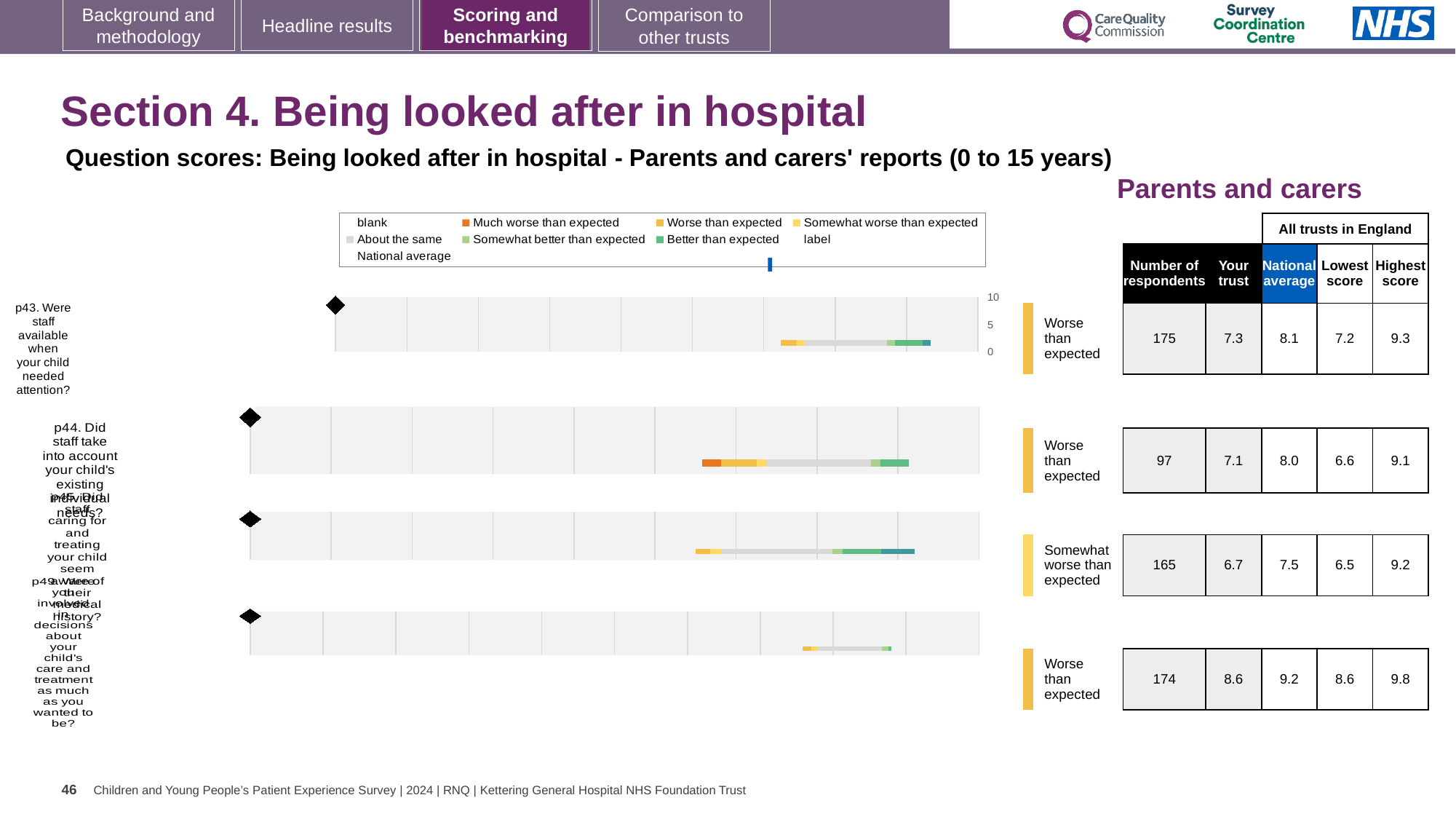
What is the lowest score across all trusts in England for the fourth chart (the question with 174 respondents)? 8.6 How many respondents answered p44 'Did staff take into account your child's existing individual needs?' 97 What is the 'Your trust' score for p43 'Were staff available when your child needed attention?' 7.3 How many question benchmark charts are shown on the slide? 4 For p43, what is the difference between the highest score and the lowest score across all trusts in England? 2.1 What is the highest score across all trusts in England for p44 'Did staff take into account your child's existing individual needs?' 9.1 What benchmark category is given for the third chart (the question with 165 respondents)? Somewhat worse than expected What kind of chart is used to show the benchmark for p43 'Were staff available when your child needed attention?' Bar chart What is the highest 'Your trust' score among the four questions shown? 8.6 What is the national average score for p43 'Were staff available when your child needed attention?' 8.1 For p43, which is larger: the 'Your trust' score or the national average? National average For p44, how much higher is the national average than the 'Your trust' score? 0.9